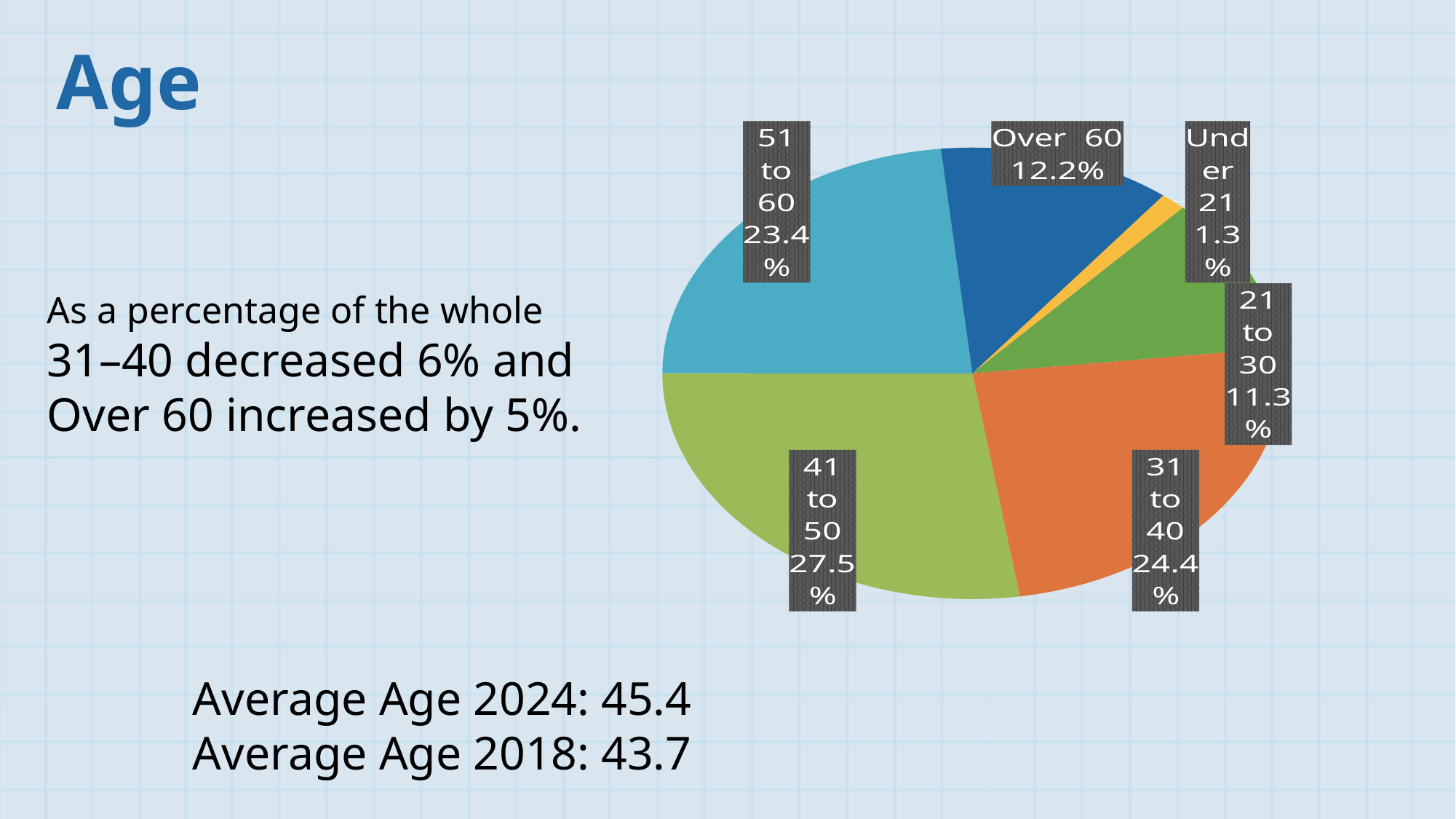
How many age groups are shown in the pie chart? 6 What is the difference in percentage points between the Over 60 group and the Under 21 group? 10.9 Which age group has the smallest share of the pie? Under 21 Which is larger, the share for 31 to 40 or the share for 51 to 60? 31 to 40 What percentage of the whole is the Over 60 age group? 12.2% What kind of chart is shown on the slide? pie chart What percentage of the whole is the 21 to 30 age group? 11.3% What is the difference in percentage points between the 41 to 50 group and the 31 to 40 group? 3.1 What percentage of the whole is the Under 21 age group? 1.3% What percentage of the whole is the 41 to 50 age group? 27.5% Which age group has the largest share of the pie? 41 to 50 What colour is the slice for the 31 to 40 age group? orange